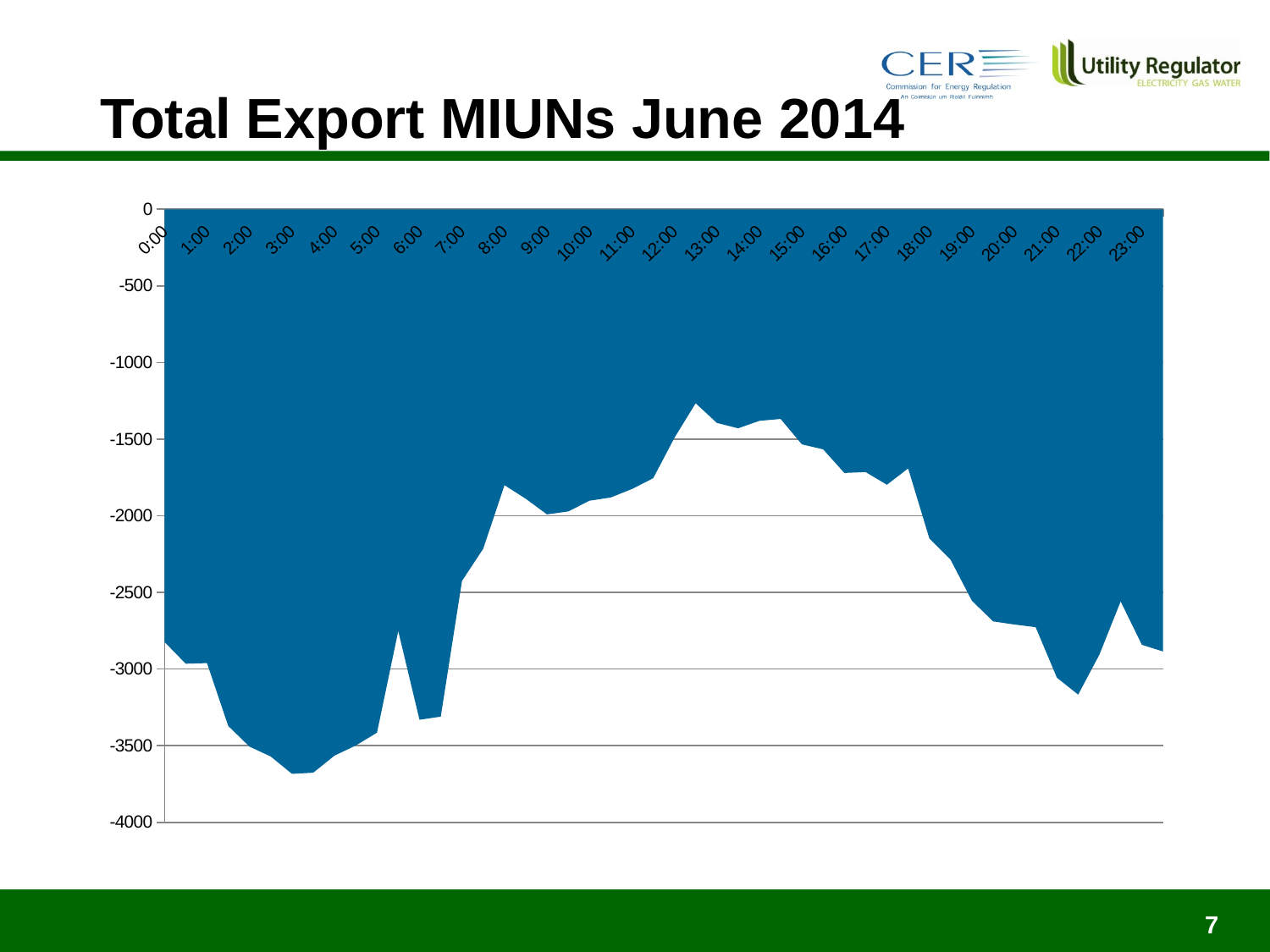
Between 7:00 and 13:00, do the values rise or fall? rise What colour is the plotted area? blue Is the value at 21:00 greater or less than -3000? less Is the value at 6:00 greater or less than -3000? less Is the value at 17:00 greater or less than -2000? greater What kind of chart is shown on the slide? area chart What is the title of the chart? Total Export MIUNs June 2014 How many hourly points are plotted along the x axis? 24 Which is larger, the value at 8:00 or the value at 6:00? 8:00